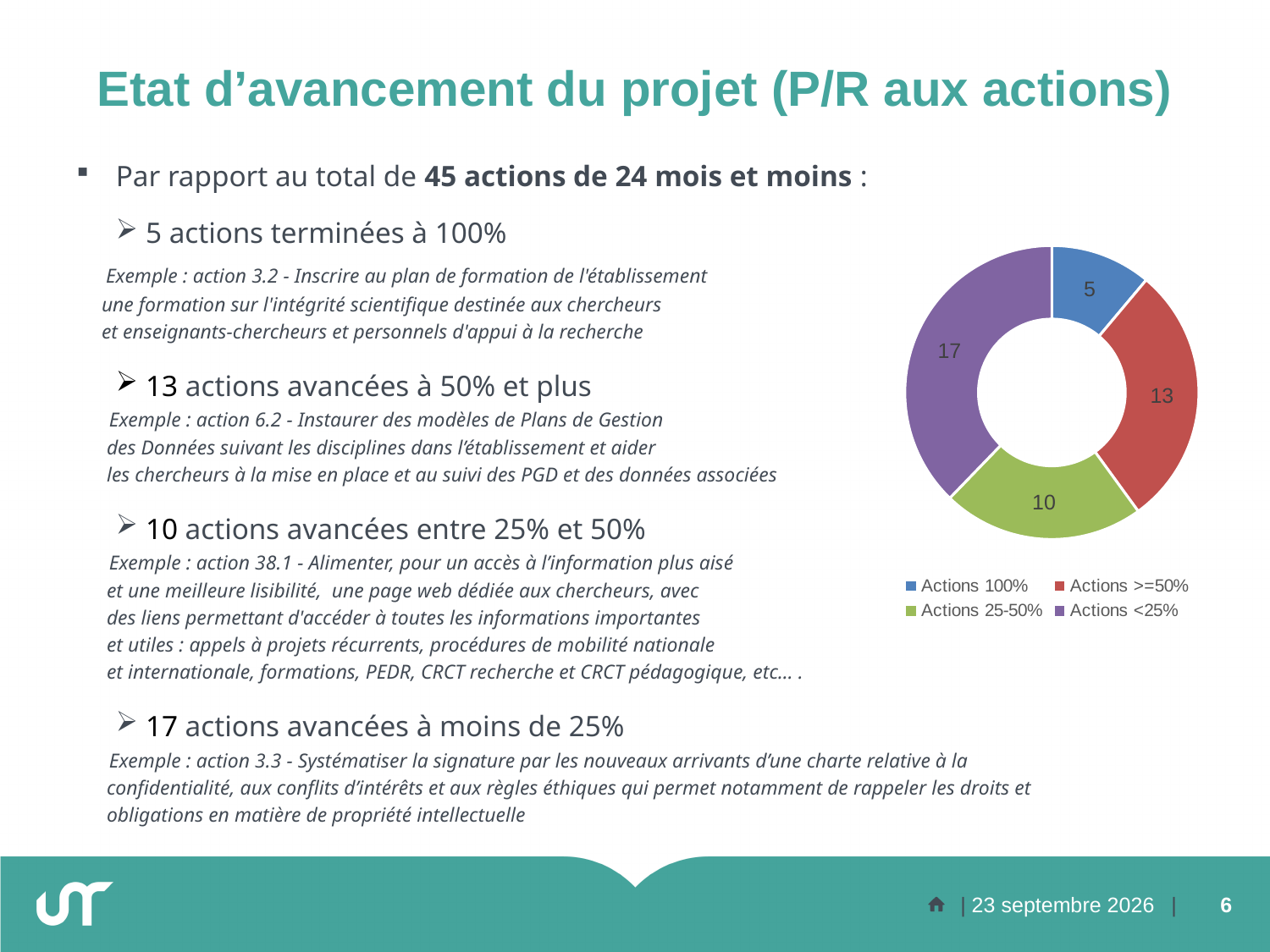
What colour is the 'Actions <25%' slice in the chart? Purple What value is shown for the 'Actions 100%' slice of the doughnut chart? 5 What value is shown for the 'Actions <25%' slice of the doughnut chart? 17 What is the total of all the values shown in the doughnut chart? 45 Which category has the smallest slice in the doughnut chart? Actions 100% What value is shown for the 'Actions 25-50%' slice of the doughnut chart? 10 Which category has the largest slice in the doughnut chart? Actions <25% How many slices does the doughnut chart have? 4 What value is shown for the 'Actions >=50%' slice of the doughnut chart? 13 What is the difference between the 'Actions <25%' value and the 'Actions 100%' value in the chart? 12 What type of chart is shown on the slide? Doughnut (pie) chart Which is larger in the chart: 'Actions >=50%' or 'Actions 25-50%'? Actions >=50%